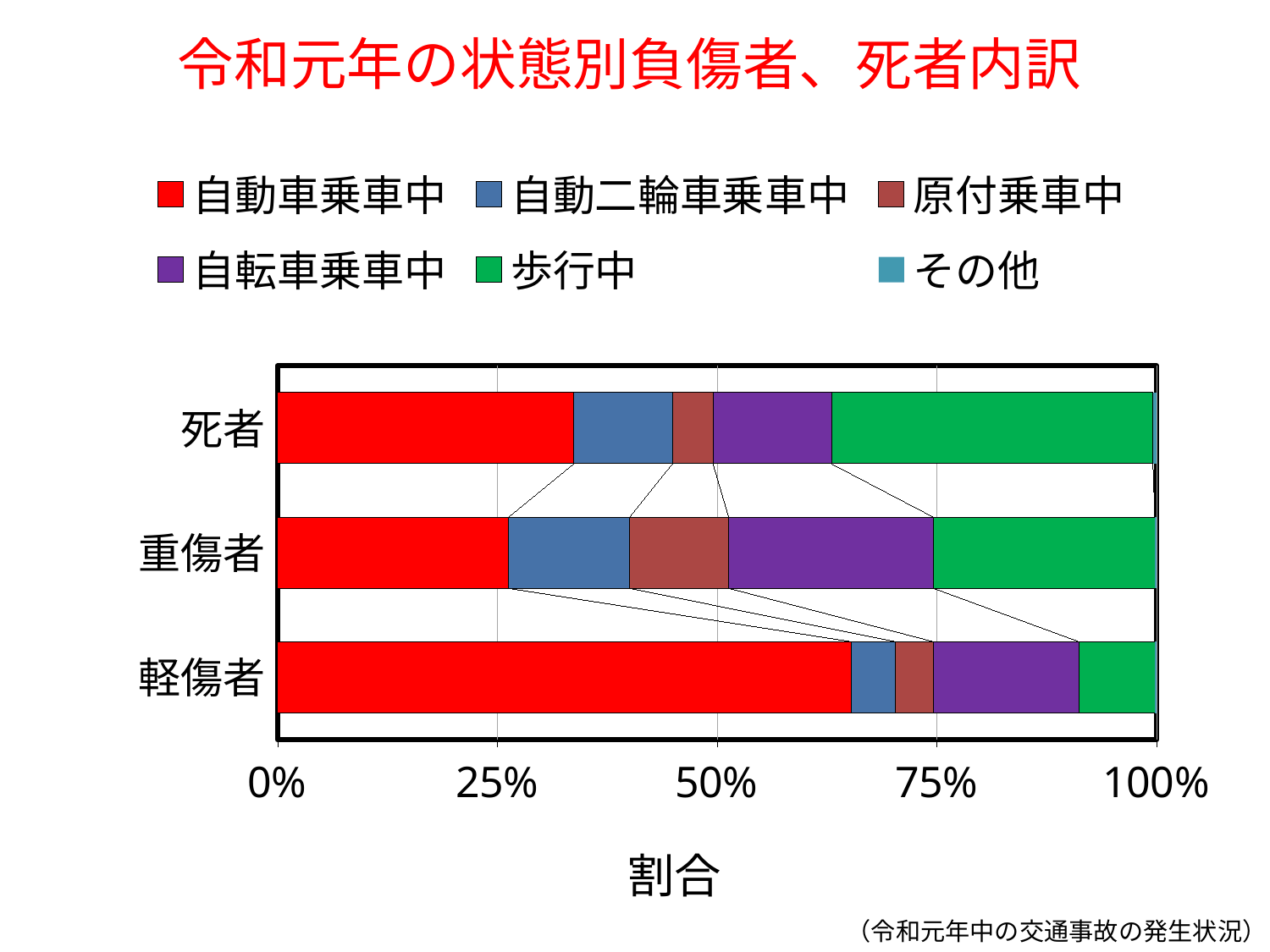
How many categories (bars) are plotted on the chart? 3 Which category has the largest 歩行中 share: 死者, 重傷者 or 軽傷者? 死者 Is the 歩行中 share larger for 死者 or for 軽傷者? 死者 Which category has the largest 自動車乗車中 share: 死者, 重傷者 or 軽傷者? 軽傷者 What is the label of the horizontal axis? 割合 What kind of chart is shown on the slide? Stacked bar chart Is the 自動車乗車中 share for 重傷者 greater or less than 50%? less How many series does the legend list? 6 Is the 自動車乗車中 share for 死者 greater or less than 50%? less Which category has the smallest 自動二輪車乗車中 share? 軽傷者 Is the 自動車乗車中 share for 軽傷者 greater or less than 50%? greater What is the title of the chart? 令和元年の状態別負傷者、死者内訳